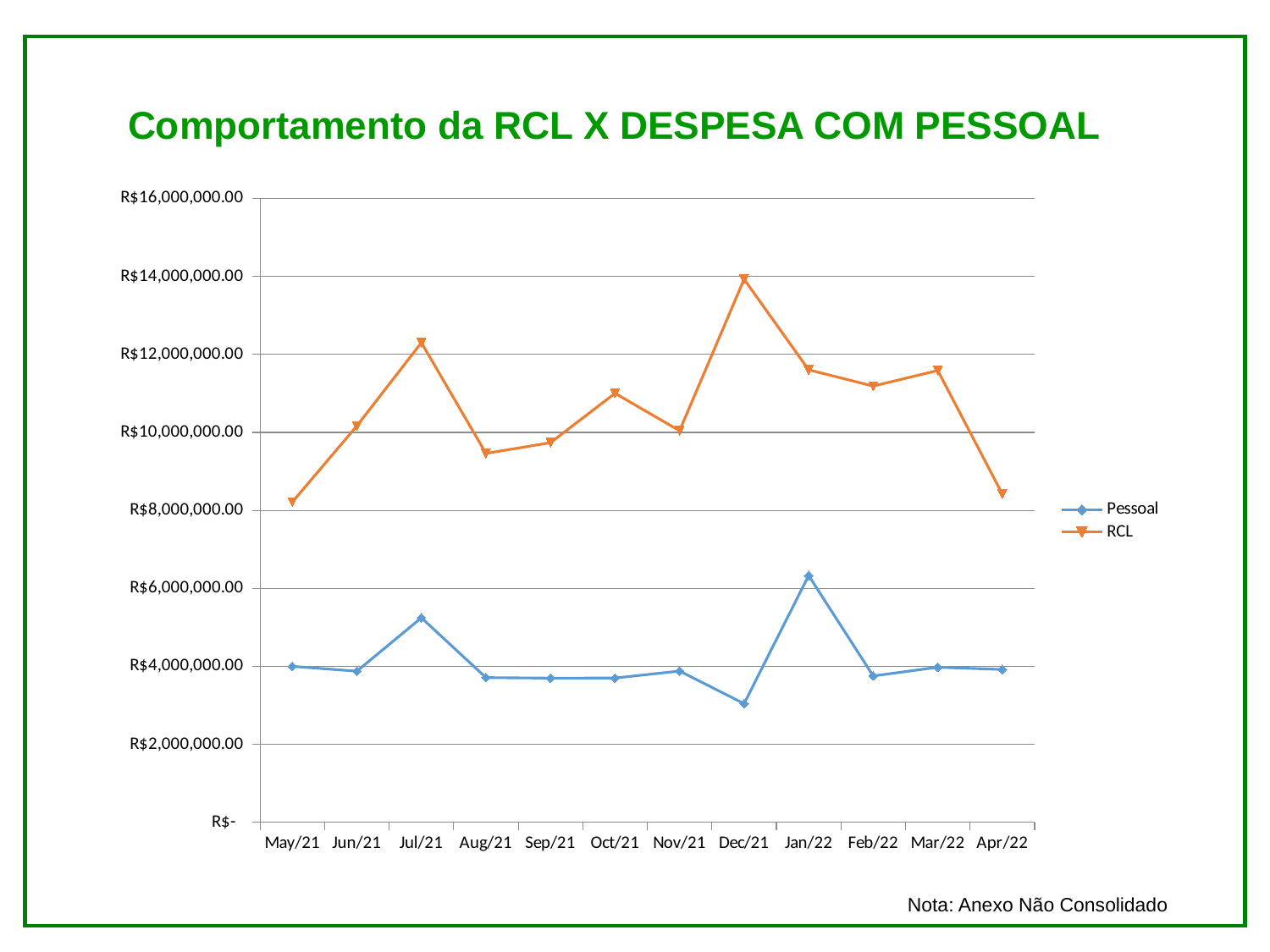
In which month does the Pessoal series reach its highest value? Jan/22 Is the RCL value for Aug/21 greater or less than R$10,000,000.00? less Which is larger, the RCL value for Jul/21 or the RCL value for Oct/21? Jul/21 How many series does the legend list? 2 In which month does the Pessoal series reach its lowest value? Dec/21 Does the RCL series rise or fall from Mar/22 to Apr/22? fall What type of chart is shown on the slide? line chart Is the RCL value for Dec/21 greater or less than R$12,000,000.00? greater What is the title of the chart? Comportamento da RCL X DESPESA COM PESSOAL In which month does the RCL series reach its highest value? Dec/21 Is the Pessoal value for Dec/21 greater or less than R$4,000,000.00? less How many months are plotted along the x axis? 12